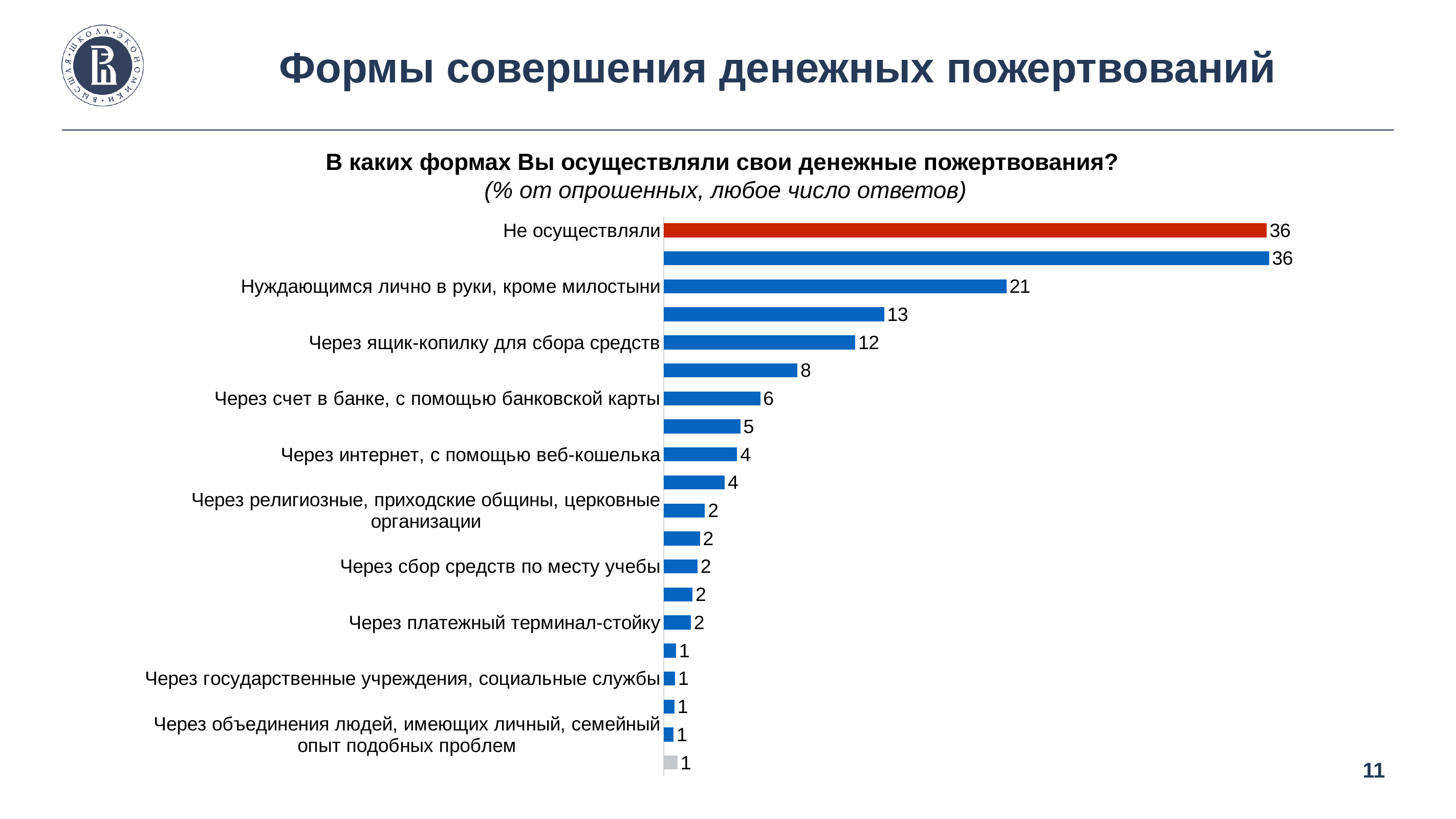
Which is larger: the value for "Через счет в банке, с помощью банковской карты" or for "Через интернет, с помощью веб-кошелька"? Через счет в банке, с помощью банковской карты What is the difference between the values for "Не осуществляли" and "Нуждающимся лично в руки, кроме милостыни"? 15 What is the value for "Через счет в банке, с помощью банковской карты"? 6 How many bars are plotted in the chart? 20 What is the value for "Через ящик-копилку для сбора средств"? 12 What colour is the bar for "Не осуществляли"? Red What kind of chart is shown on the slide? Bar chart What is the difference between the values for "Нуждающимся лично в руки, кроме милостыни" and "Через ящик-копилку для сбора средств"? 9 What is the value for "Через государственные учреждения, социальные службы"? 1 What is the value for "Через интернет, с помощью веб-кошелька"? 4 What is the value for "Нуждающимся лично в руки, кроме милостыни"? 21 What is the value for "Не осуществляли"? 36